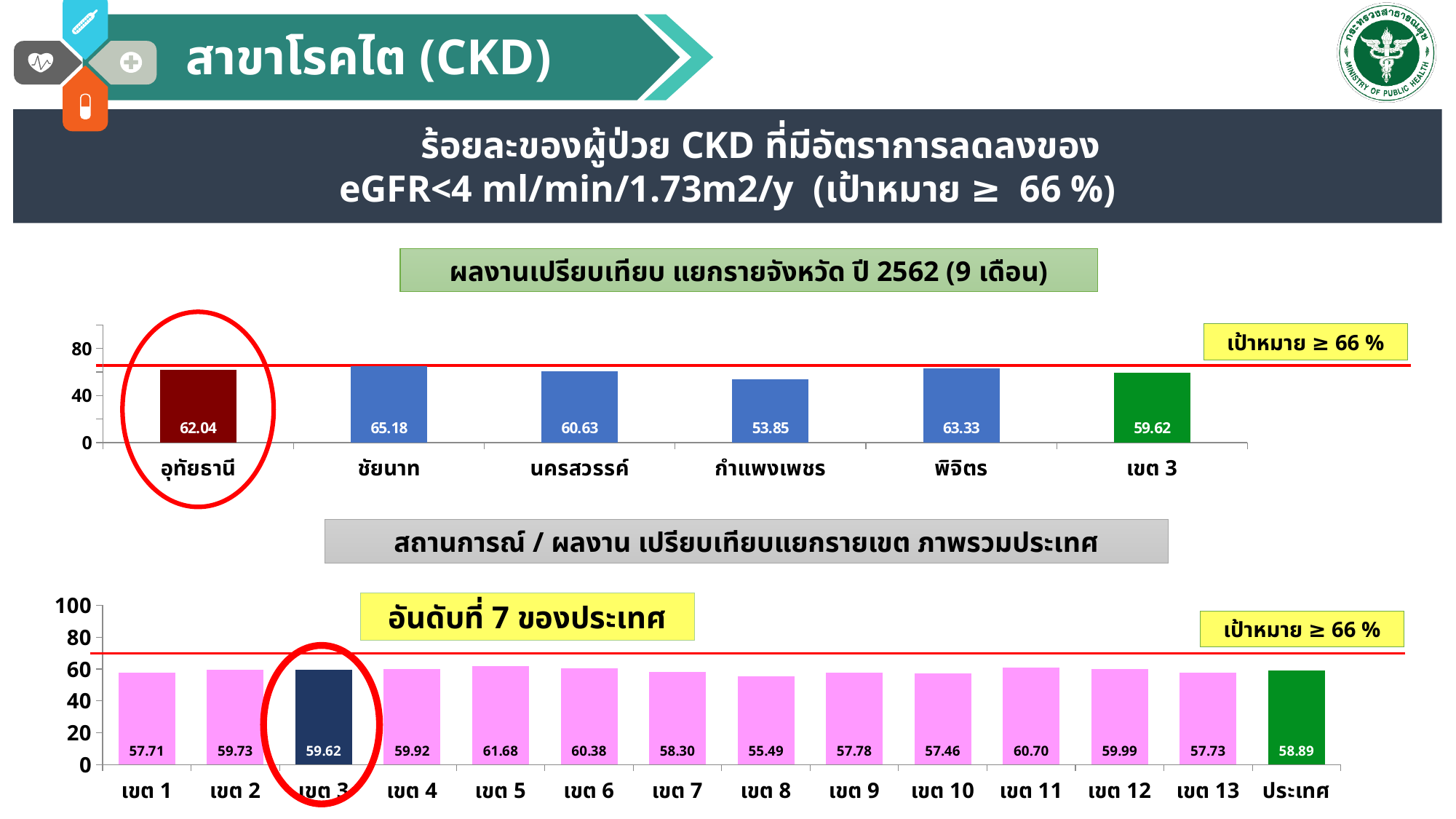
What type of chart is the bottom chart (by region, national overview)? bar chart In the bottom chart (by region, national overview), what is the value for เขต 5? 61.68 In the bottom chart (by region, national overview), what is the value for ประเทศ? 58.89 In the bottom chart (by region, national overview), which is larger, the value for เขต 11 or เขต 1? เขต 11 In the bottom chart (by region, national overview), which category has the highest value? เขต 5 In the top chart (by province, year 2562), what is the value for ชัยนาท? 65.18 In the bottom chart (by region, national overview), which region has the lowest value? เขต 8 In the top chart (by province, year 2562), which province has the lowest value? กำแพงเพชร In the top chart (by province, year 2562), what is the difference between the values for พิจิตร and อุทัยธานี? 1.29 In the top chart (by province, year 2562), how many bars are plotted? 6 In the top chart (by province, year 2562), is the value for กำแพงเพชร greater or less than 40? greater In the top chart (by province, year 2562), which category has the highest value? ชัยนาท